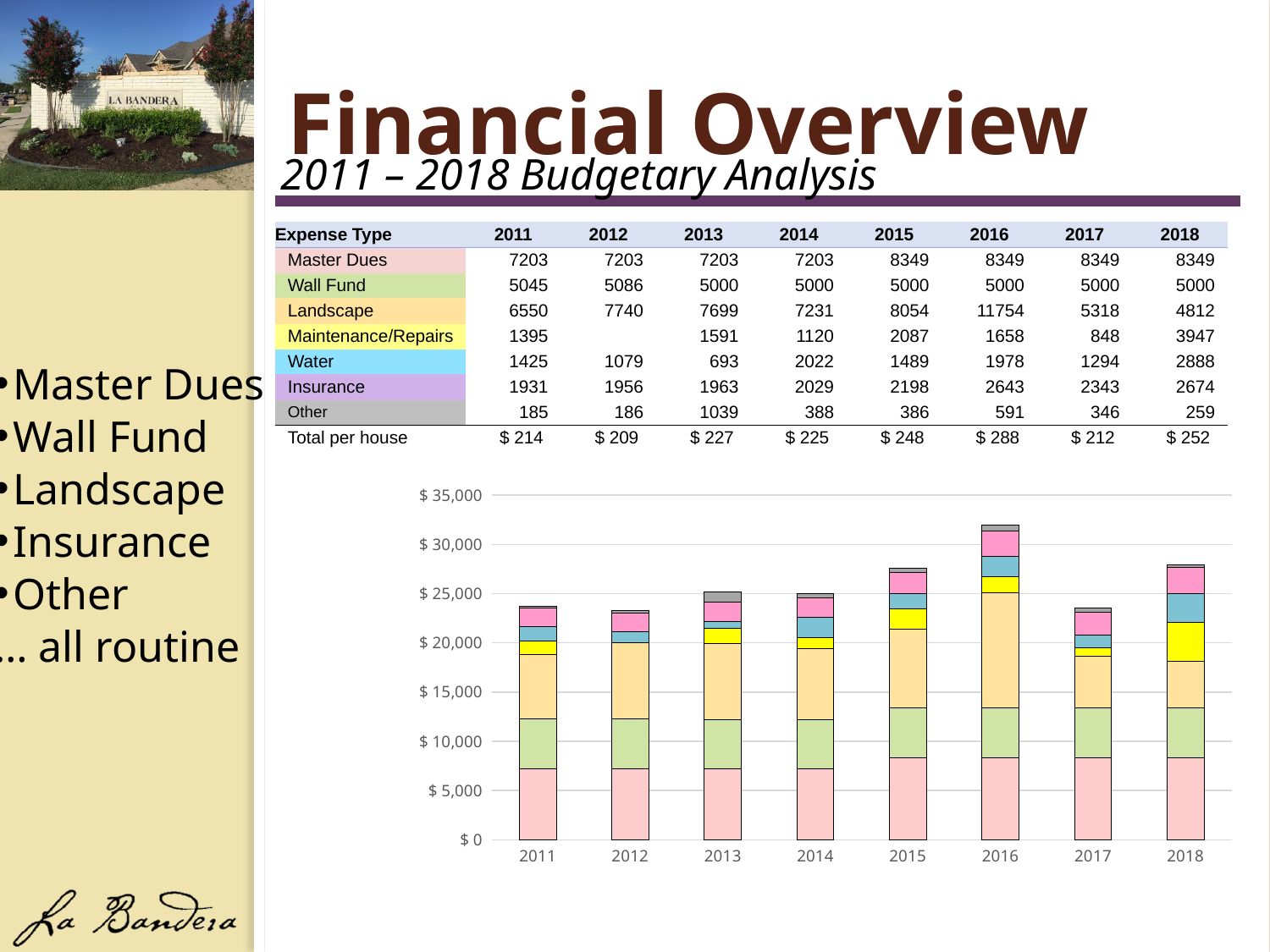
What is the highest value shown on the chart's y axis? $ 35,000 Which year has the larger total bar, 2015 or 2016? 2016 Is the total stacked bar for 2018 greater or less than $ 25,000? greater According to the table above the chart, what is the Total per house for 2016? $ 288 How many years (bars) are plotted on the x axis of the chart? 8 Which year has the larger total bar, 2017 or 2018? 2018 Which year has the tallest stacked bar in the chart? 2016 Is the total stacked bar for 2017 greater or less than $ 25,000? less Is the total stacked bar for 2016 greater or less than $ 30,000? greater What kind of chart is shown on the slide? stacked bar chart According to the table above the chart, what is the Landscape expense for 2016? 11754